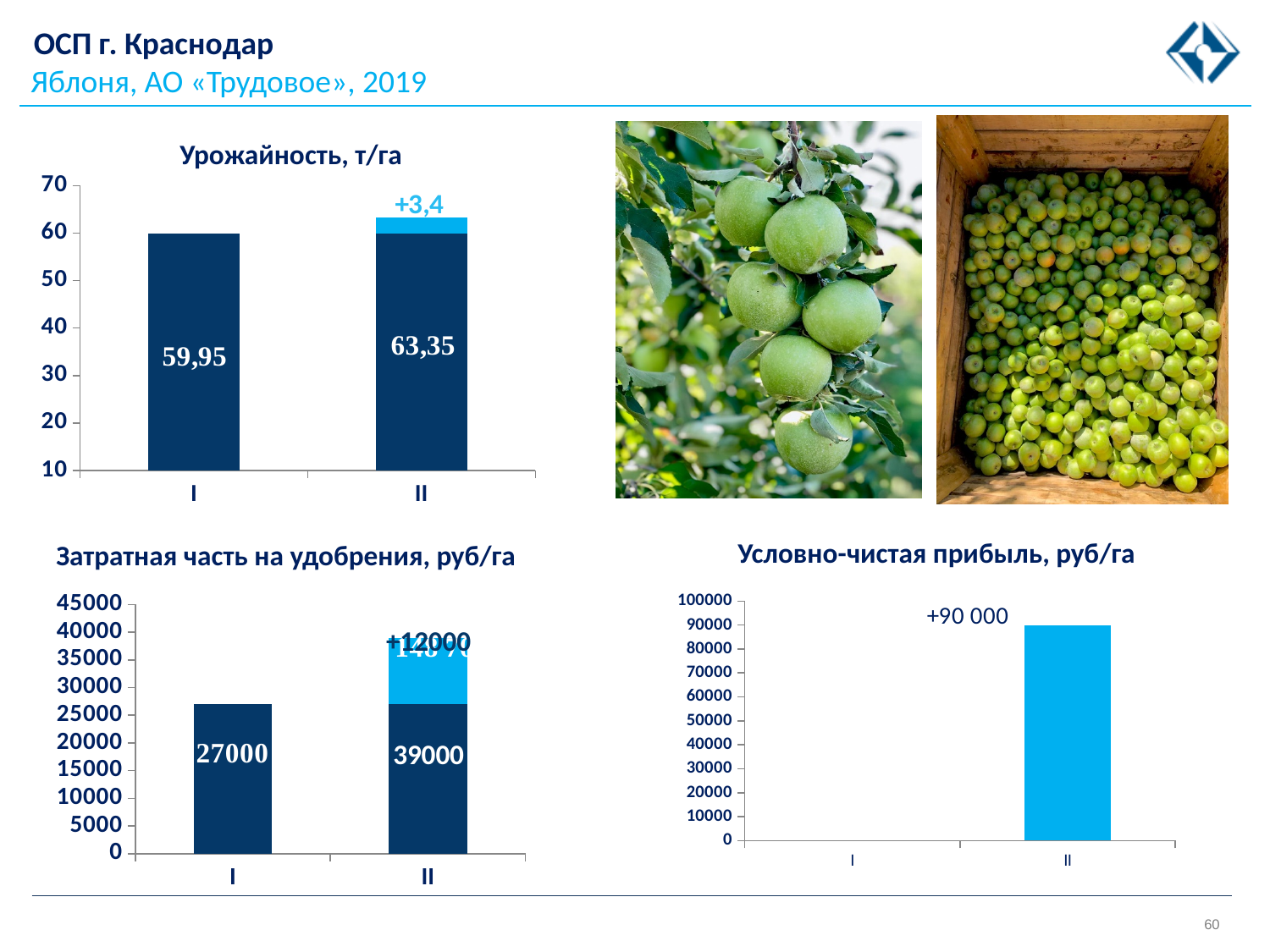
In the chart titled "Урожайность, т/га", which category has the higher value? II In the chart titled "Урожайность, т/га", what is the value for category I? 59,95 In the chart titled "Затратная часть на удобрения, руб/га", what is the value for category I? 27000 In the chart titled "Условно-чистая прибыль, руб/га", how many categories are shown on the x axis? 2 What kind of chart is the one titled "Урожайность, т/га"? bar chart In the chart titled "Затратная часть на удобрения, руб/га", which category has the lower value? I In the chart titled "Условно-чистая прибыль, руб/га", what value is labelled for category II? +90 000 In the chart titled "Урожайность, т/га", is the value for category I greater or less than 50? greater In the chart titled "Урожайность, т/га", what increase is labelled above the bar for category II? +3,4 In the chart titled "Затратная часть на удобрения, руб/га", what is the difference between the values for category II and category I? 12000 In the chart titled "Затратная часть на удобрения, руб/га", what is the value for category II? 39000 In the chart titled "Урожайность, т/га", what is the value for category II? 63,35